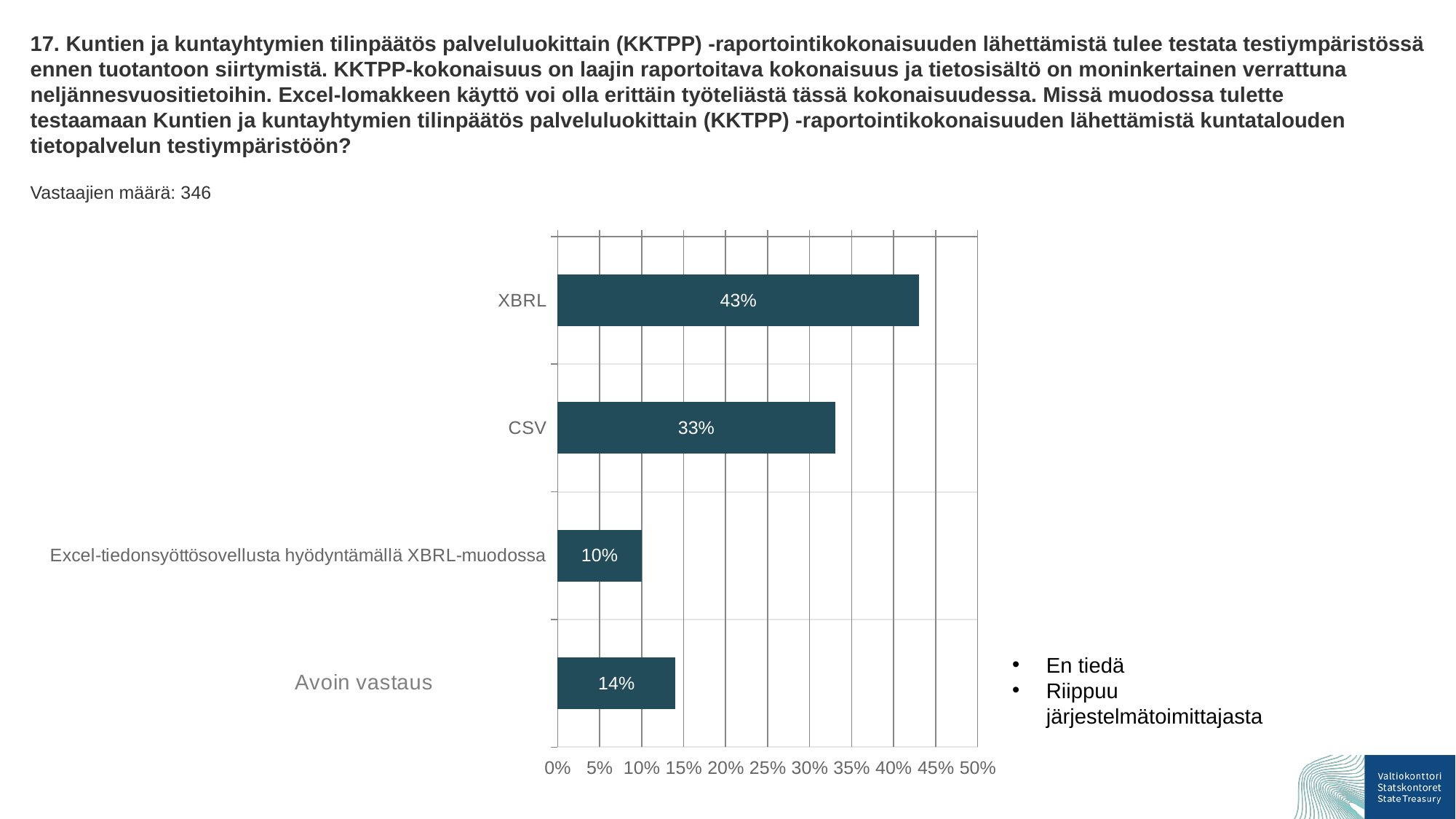
Which category has the highest value? XBRL Which is larger, the value for CSV or the value for 'Avoin vastaus'? CSV How many respondents (Vastaajien määrä) are reported on the slide? 346 How many categories are shown in the chart? 4 What is the value shown for CSV? 33% What percentage is shown for 'Excel-tiedonsyöttösovellusta hyödyntämällä XBRL-muodossa'? 10% Which category has the lowest value? Excel-tiedonsyöttösovellusta hyödyntämällä XBRL-muodossa What percentage of respondents chose XBRL? 43% Is the value for XBRL greater or less than 40%? greater What is the value for 'Avoin vastaus'? 14% What kind of chart is shown on the slide? Horizontal bar chart What is the difference in percentage points between XBRL and CSV? 10 percentage points